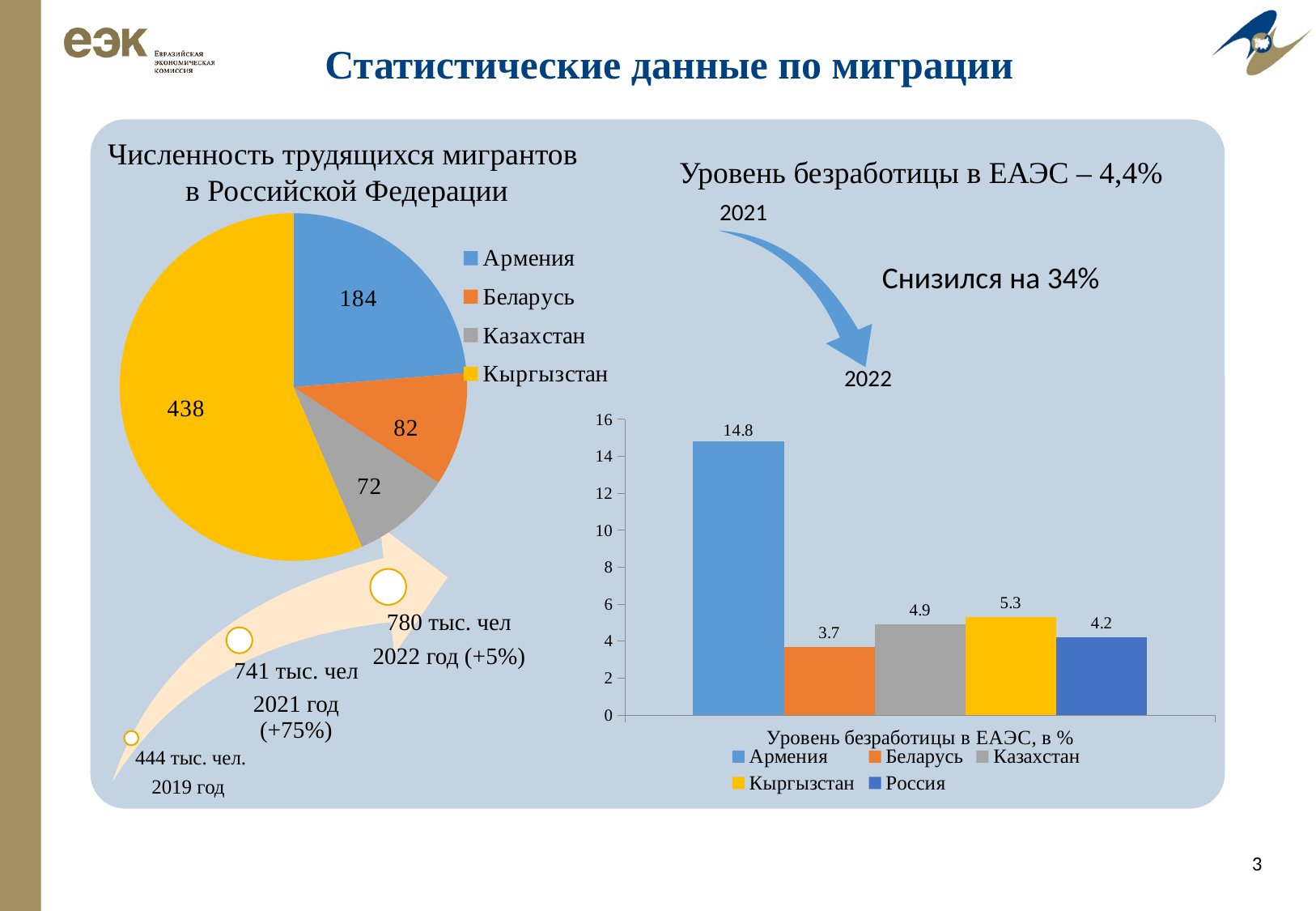
In the bar chart 'Уровень безработицы в ЕАЭС, в %', which country has the highest unemployment rate? Армения In the pie chart 'Численность трудящихся мигрантов в Российской Федерации', which country has the largest slice? Кыргызстан In the bar chart 'Уровень безработицы в ЕАЭС, в %', which country has the lowest unemployment rate? Беларусь What type of chart is the one titled 'Численность трудящихся мигрантов в Российской Федерации'? pie chart In the pie chart 'Численность трудящихся мигрантов в Российской Федерации', what is the value for Армения? 184 In the bar chart 'Уровень безработицы в ЕАЭС, в %', what is the difference between the values for Армения and Россия? 10.6 In the pie chart 'Численность трудящихся мигрантов в Российской Федерации', which country has the smallest slice? Казахстан In the pie chart 'Численность трудящихся мигрантов в Российской Федерации', how many countries are listed in the legend? 4 In the bar chart 'Уровень безработицы в ЕАЭС, в %', what is the value for Беларусь? 3.7 In the pie chart 'Численность трудящихся мигрантов в Российской Федерации', what is the difference between the values for Кыргызстан and Армения? 254 How many series does the legend of the bar chart 'Уровень безработицы в ЕАЭС, в %' list? 5 In the bar chart 'Уровень безработицы в ЕАЭС, в %', which is larger: the value for Кыргызстан or the value for Казахстан? Кыргызстан